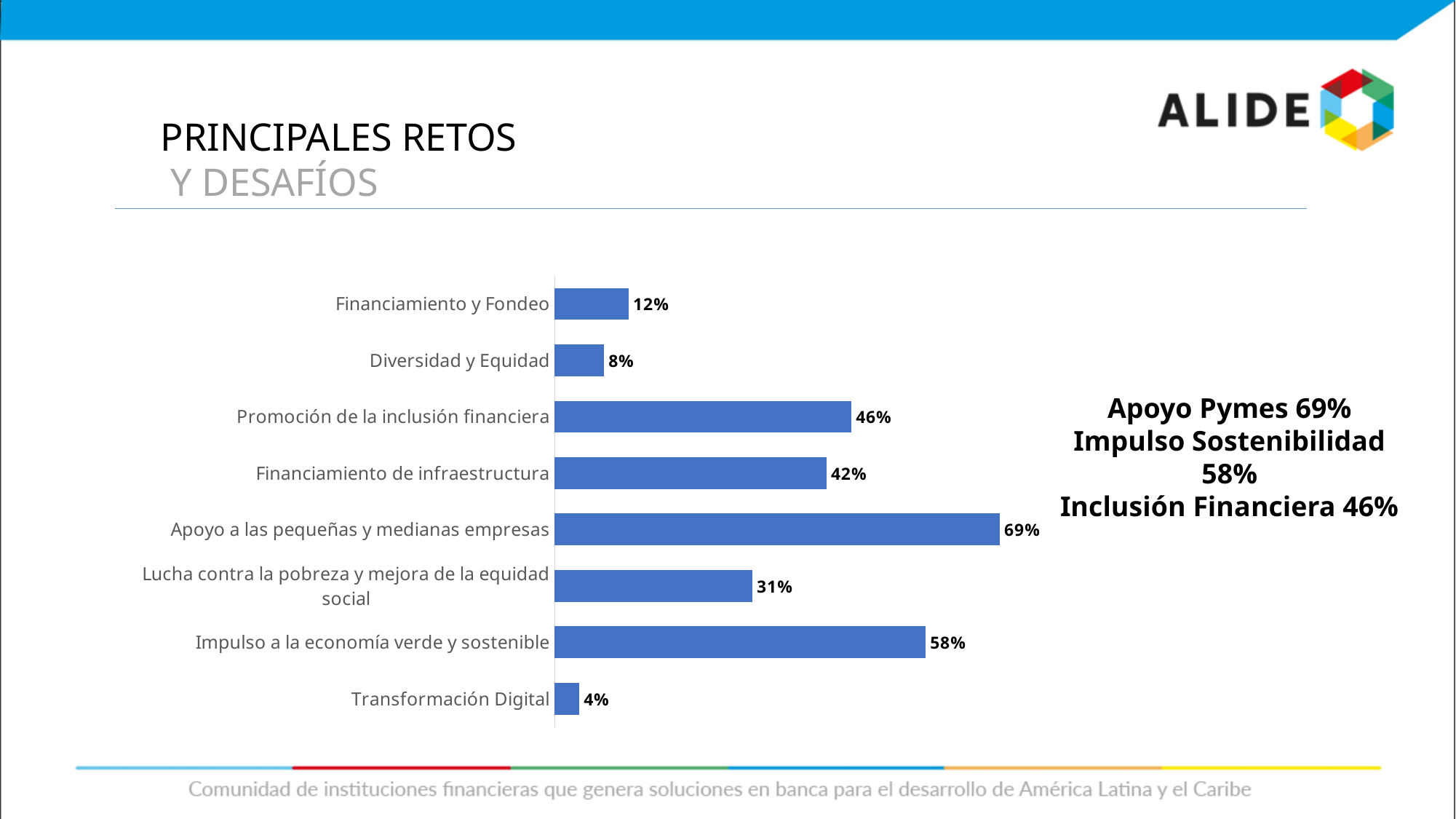
What is the value for Lucha contra la pobreza y mejora de la equidad social? 31% What is the value for Apoyo a las pequeñas y medianas empresas? 69% What is the difference between Promoción de la inclusión financiera and Financiamiento de infraestructura? 4% Which category has the lowest value? Transformación Digital What is the value for Transformación Digital? 4% Which category has the highest value? Apoyo a las pequeñas y medianas empresas How many categories are shown in the chart? 8 What is the value for Impulso a la economía verde y sostenible? 58% What is the difference between Apoyo a las pequeñas y medianas empresas and Impulso a la economía verde y sostenible? 11% Which is larger, Financiamiento y Fondeo or Diversidad y Equidad? Financiamiento y Fondeo What is the value for Financiamiento de infraestructura? 42% What kind of chart is shown on the slide? Bar chart